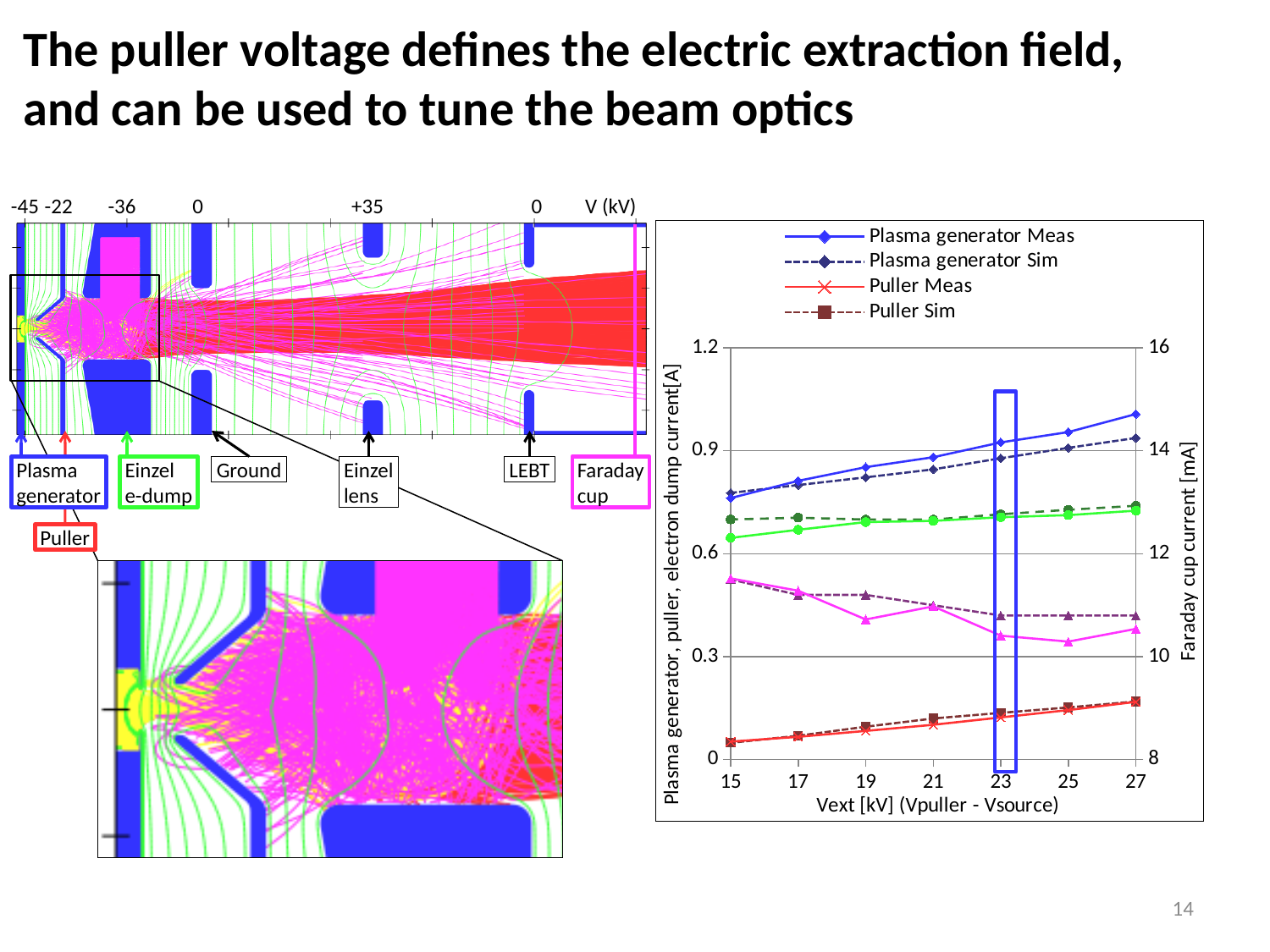
How many x-axis tick values are shown on the chart? 7 Does the Puller Meas series rise or fall as Vext increases from 15 to 27 kV? rise At 27 kV, which is larger: Plasma generator Meas or Puller Meas? Plasma generator Meas What is the x-axis label of the chart? Vext [kV] (Vpuller - Vsource) Is the value for Plasma generator Meas at 15 kV greater or less than 0.9? less What kind of chart is shown on the right side of the slide? line chart How many series does the chart legend list? 4 Does the Plasma generator Meas series rise or fall as Vext increases from 15 to 27 kV? rise Is the value for Puller Meas at 15 kV greater or less than 0.3? less Is the value for Plasma generator Meas at 27 kV greater or less than 0.9? greater What is the label of the right-hand y axis of the chart? Faraday cup current [mA]